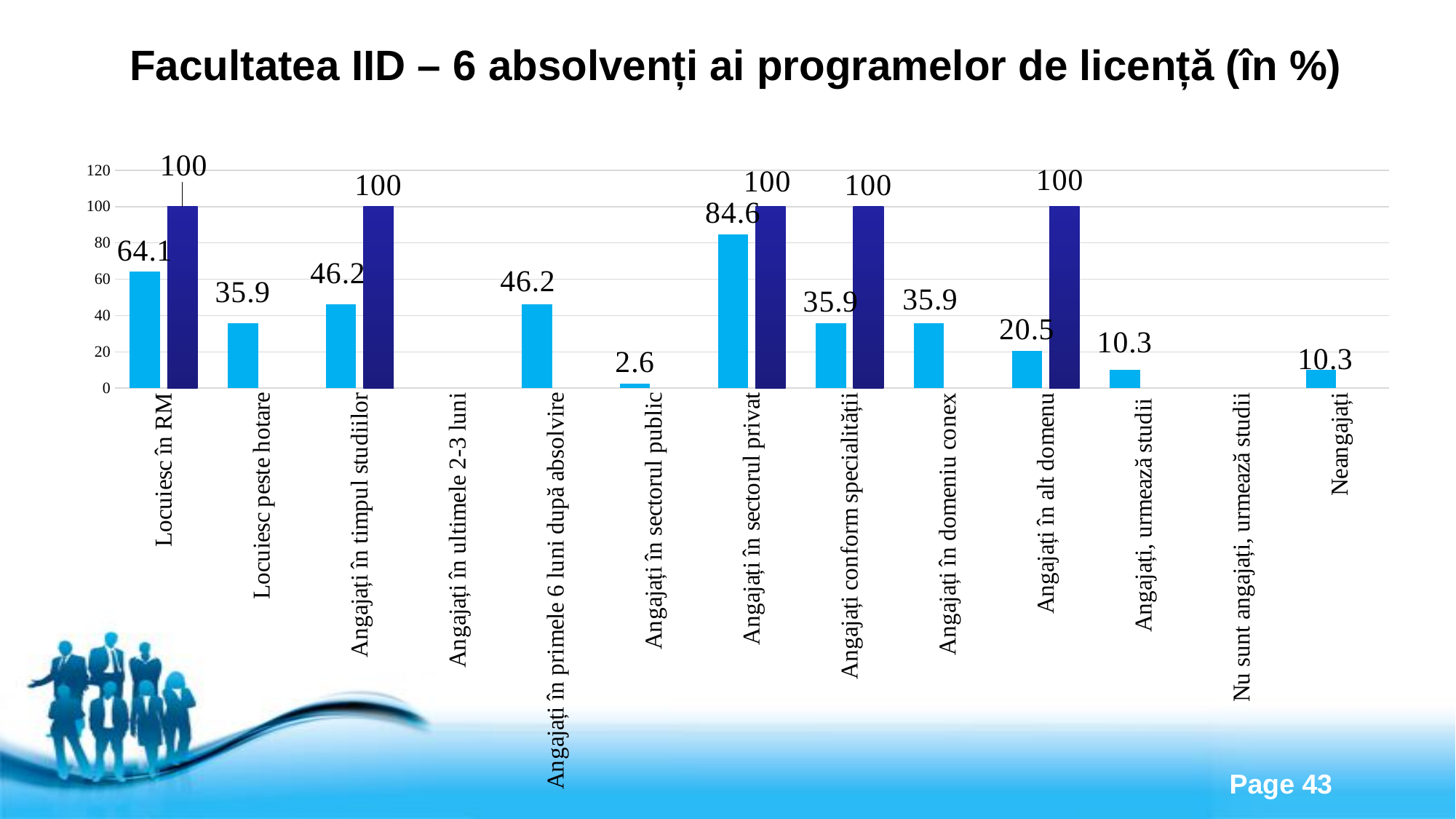
How many categories are shown on the x axis? 13 Which category has the highest light blue bar? Angajați în sectorul privat Which category has the lowest labelled light blue bar? Angajați în sectorul public What is the title of the slide? Facultatea IID – 6 absolvenți ai programelor de licență (în %) What is the light blue bar value for "Angajați în sectorul public"? 2.6 What is the light blue bar value for "Locuiesc în RM"? 64.1 What type of chart is shown on the slide? Bar chart What is the light blue bar value for "Angajați în sectorul privat"? 84.6 What is the light blue bar value for "Angajați în alt domeniu"? 20.5 What is the value of the dark blue bar for "Angajați conform specialității"? 100 Which is larger: the light blue value for "Angajați în timpul studiilor" or for "Angajați conform specialității"? Angajați în timpul studiilor What is the difference between the light blue values for "Locuiesc în RM" and "Locuiesc peste hotare"? 28.2